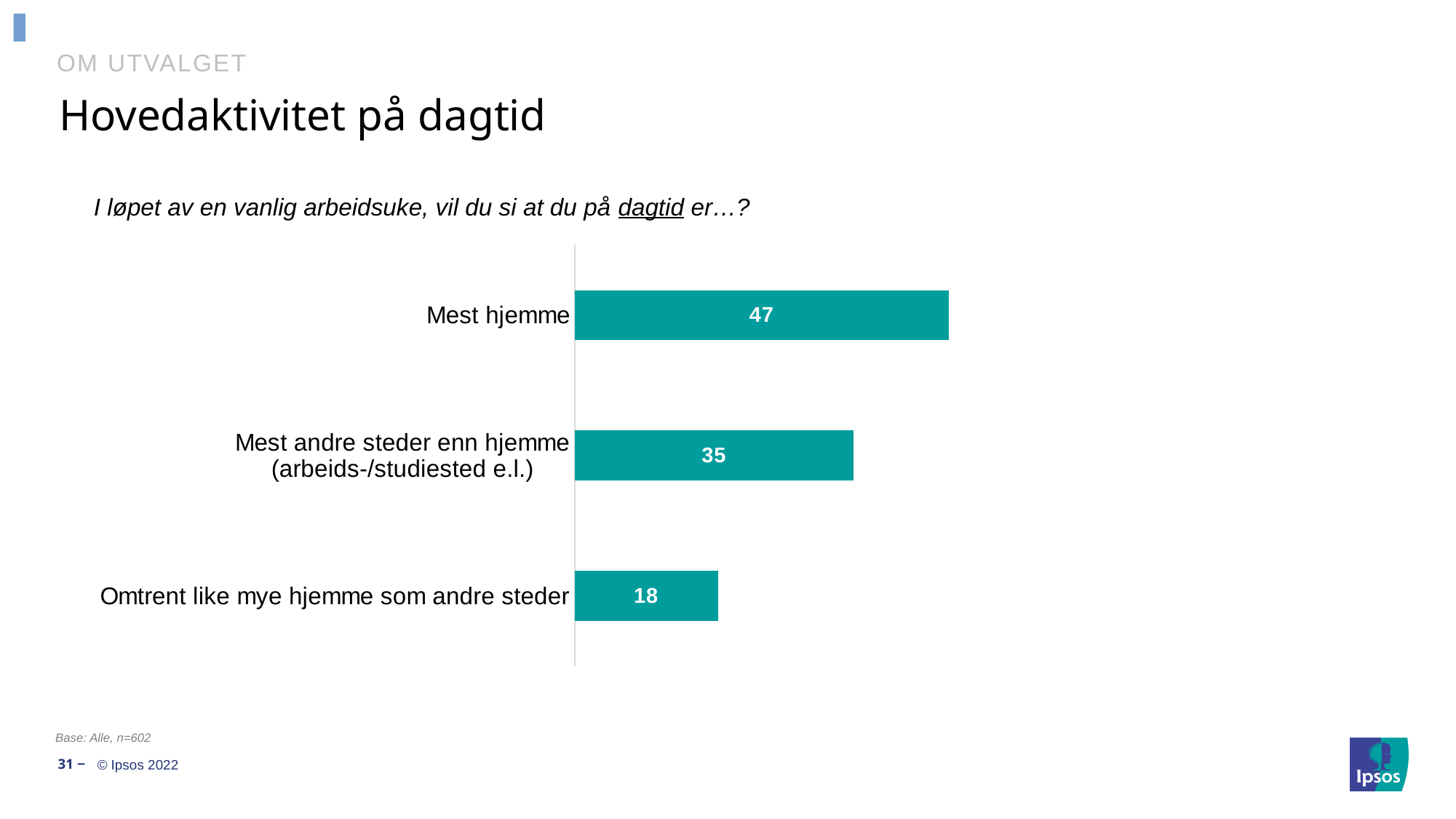
How many categories are shown in the chart? 3 Which category has the highest value? Mest hjemme What is the difference between the values for "Mest andre steder enn hjemme (arbeids-/studiested e.l.)" and "Omtrent like mye hjemme som andre steder"? 17 Which category has the lowest value? Omtrent like mye hjemme som andre steder What is the value for "Omtrent like mye hjemme som andre steder"? 18 What colour are the bars in the chart? Teal What is the value for "Mest andre steder enn hjemme (arbeids-/studiested e.l.)"? 35 What is the value for "Mest hjemme"? 47 What kind of chart is shown on the slide? Bar chart What is the difference between the values for "Mest hjemme" and "Mest andre steder enn hjemme (arbeids-/studiested e.l.)"? 12 What is the title of the slide? Hovedaktivitet på dagtid Which is larger: the value for "Mest hjemme" or the value for "Omtrent like mye hjemme som andre steder"? Mest hjemme